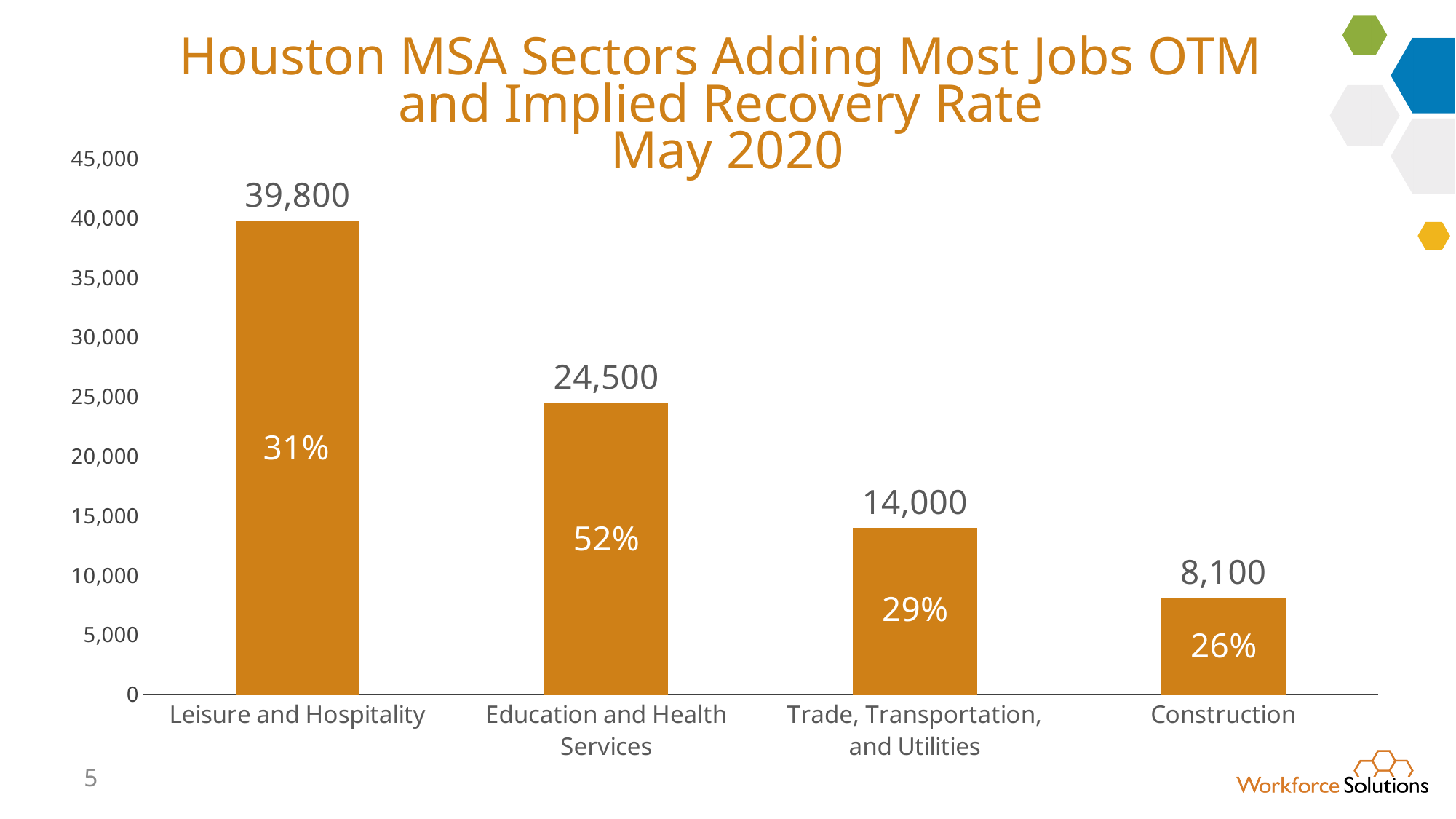
Which added more jobs over the month: Trade, Transportation, and Utilities or Construction? Trade, Transportation, and Utilities How many jobs did Education and Health Services add over the month? 24,500 How many sectors are shown in the chart? 4 Which sector added the most jobs over the month? Leisure and Hospitality Which sector has the highest implied recovery rate? Education and Health Services How many jobs did Leisure and Hospitality add over the month? 39,800 What is the implied recovery rate shown for Construction? 26% Do the jobs-added values rise or fall from left to right across the sectors? Fall What is the difference in jobs added between Leisure and Hospitality and Education and Health Services? 15,300 What is the implied recovery rate shown for Trade, Transportation, and Utilities? 29% What kind of chart is shown on the slide? Bar chart Which sector added the fewest jobs over the month? Construction